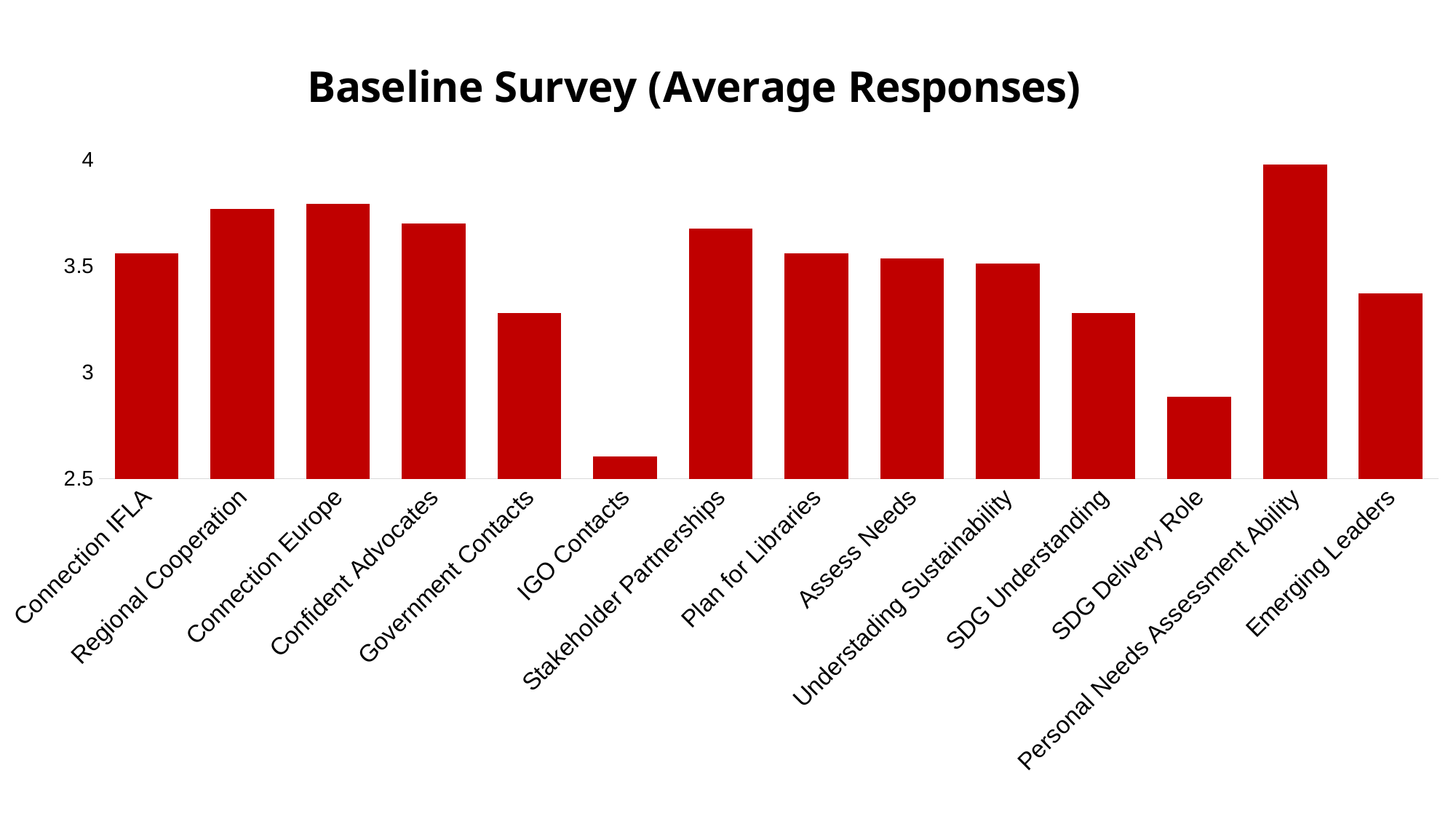
What kind of chart is shown on the slide? Bar chart Which is larger, the value for Connection Europe or the value for Government Contacts? Connection Europe Which is larger, the value for Emerging Leaders or the value for SDG Delivery Role? Emerging Leaders What is the title of the chart? Baseline Survey (Average Responses) Is the value for SDG Delivery Role greater or less than 3? less How many categories are plotted on the chart? 14 Is the value for Personal Needs Assessment Ability greater or less than 3.5? greater Which category has the highest average response? Personal Needs Assessment Ability What colour are the bars in the chart? Red Is the value for Government Contacts greater or less than 3.5? less Which category has the lowest average response? IGO Contacts